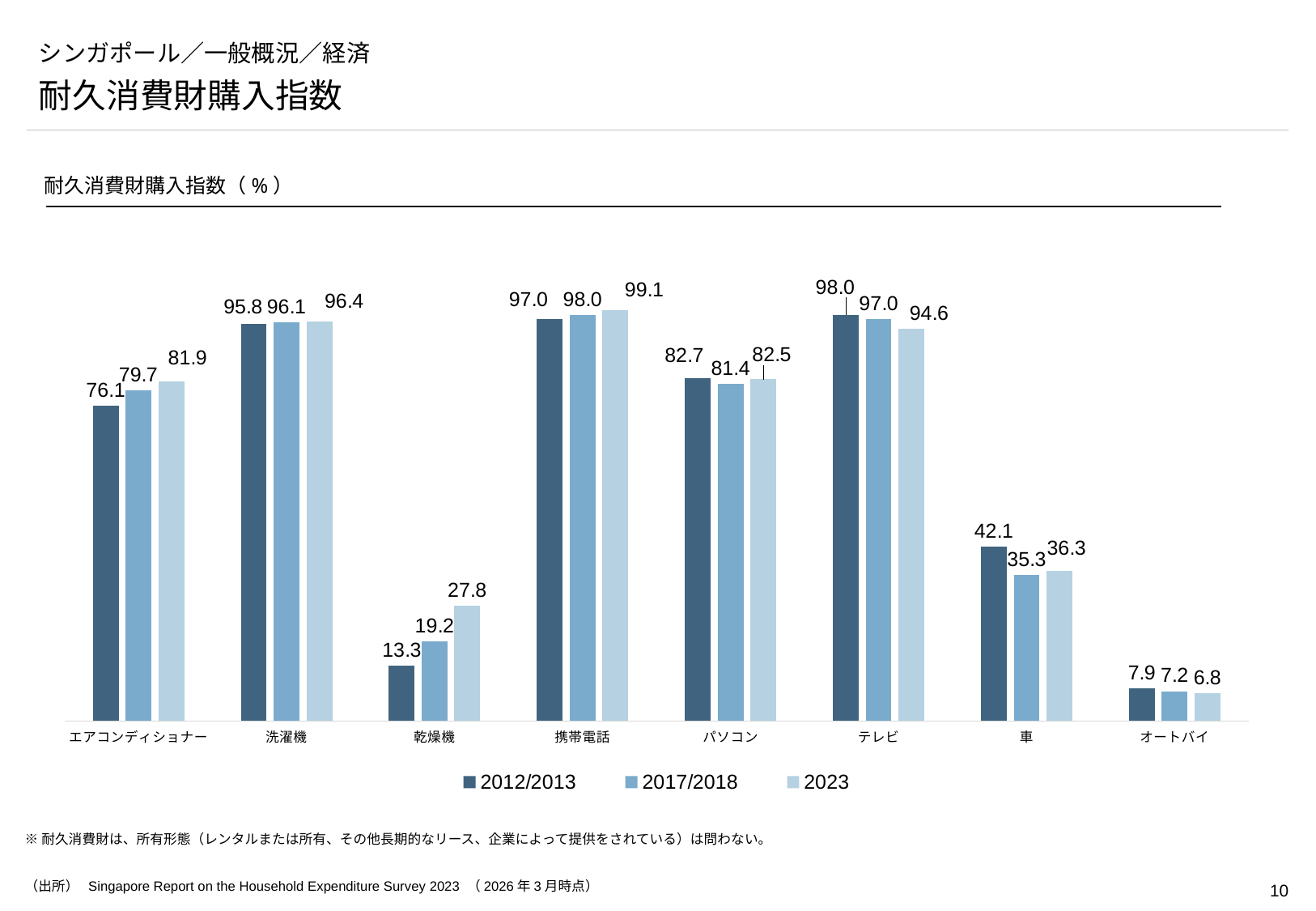
How many categories are shown on the x axis? 8 What is the title of the chart? 耐久消費財購入指数（％） Which category has the lowest value in the 2012/2013 series? オートバイ Which is larger for テレビ: the 2012/2013 value or the 2023 value? 2012/2013 Which category has the highest value in the 2023 series? 携帯電話 What kind of chart is shown on the slide? Bar chart Do the values for 車 rise or fall from 2012/2013 to 2017/2018? Fall What is the value for 乾燥機 in the 2023 series? 27.8 How many series does the legend list? 3 What is the value for エアコンディショナー in the 2017/2018 series? 79.7 What is the difference between the 2023 and 2012/2013 values for 乾燥機? 14.5 What is the value for 車 in the 2012/2013 series? 42.1